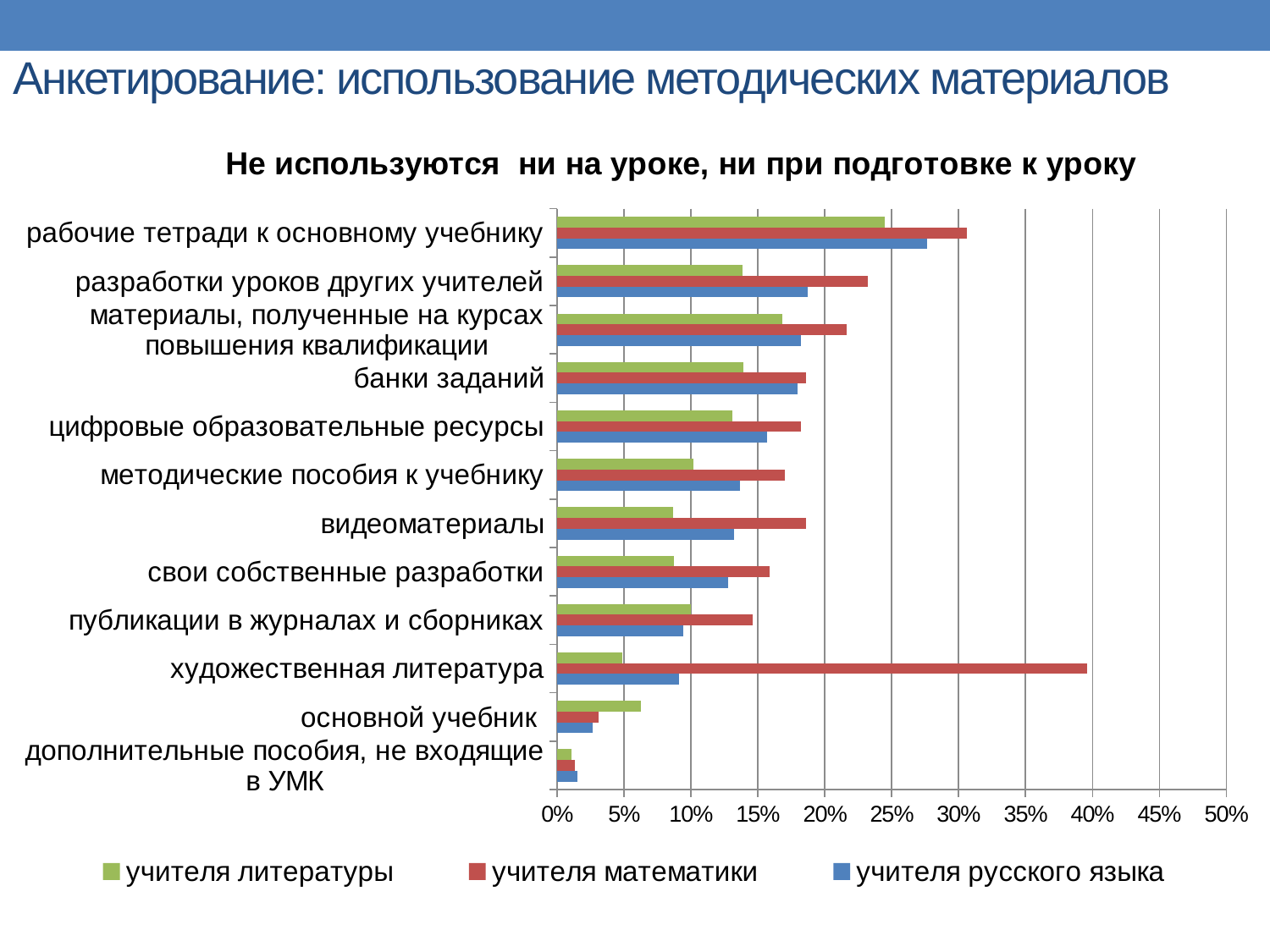
What is the title of the chart? Не используются ни на уроке, ни при подготовке к уроку For which category is the value for учителя русского языка the highest? рабочие тетради к основному учебнику How many series does the legend list? 3 Is the value for учителя литературы for рабочие тетради к основному учебнику greater or less than 20%? greater For which category is the value for учителя математики the highest? художественная литература How many categories of methodological materials are listed on the chart? 12 Is the value for учителя русского языка for рабочие тетради к основному учебнику greater or less than 25%? greater For художественная литература, which is larger: the value for учителя математики or for учителя литературы? учителя математики For основной учебник, which is larger: the value for учителя литературы or for учителя русского языка? учителя литературы For which category is the value for учителя литературы the lowest? дополнительные пособия, не входящие в УМК Is the value for учителя математики for художественная литература greater or less than 35%? greater What kind of chart is shown on the slide? bar chart